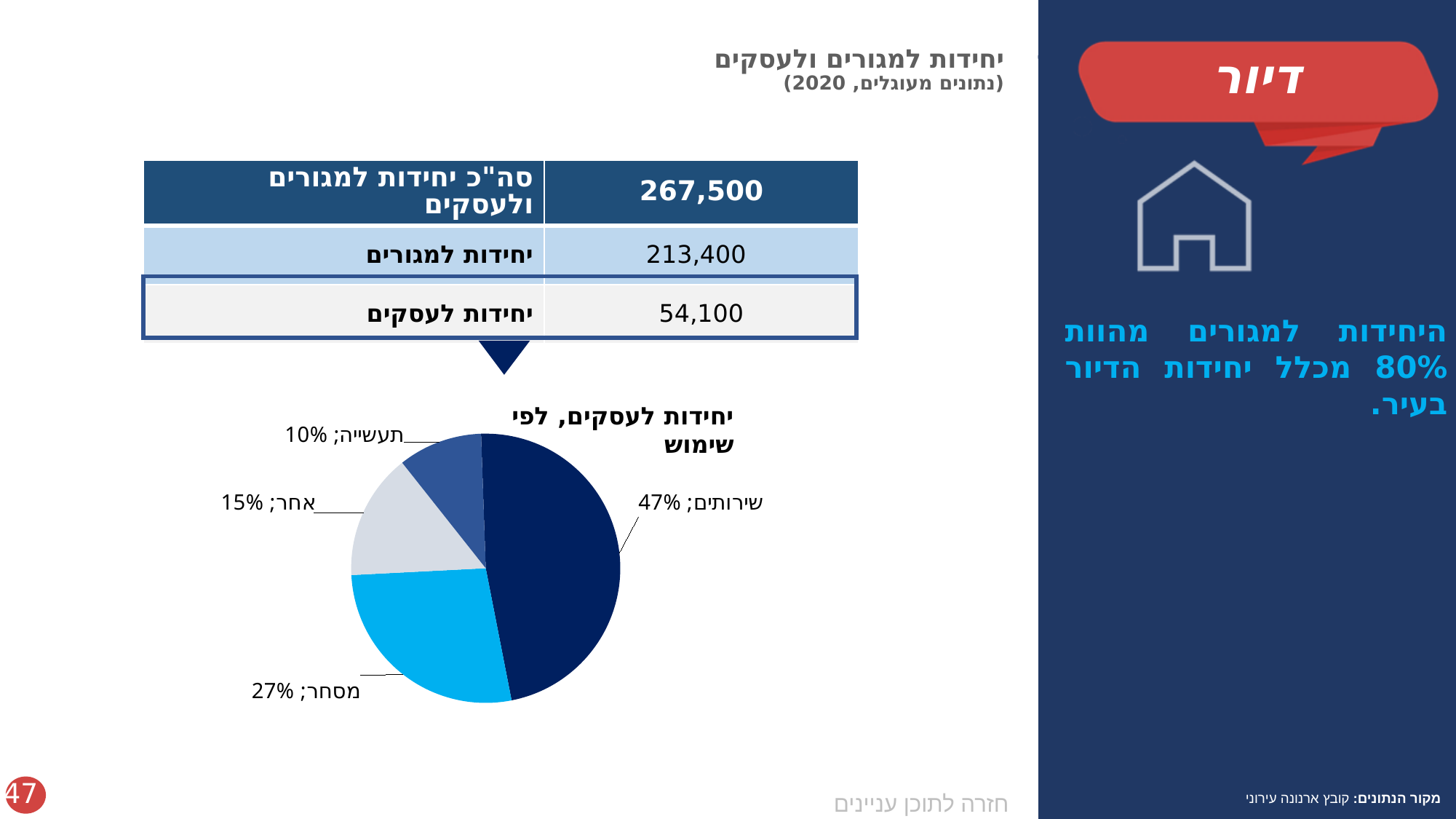
What is the difference in percentage points between מסחר and אחר? 12 Which slice of the pie chart is the smallest? תעשייה What share of the pie does שירותים have? 47% What is the difference in percentage points between שירותים and מסחר? 20 What share of the pie does אחר have? 15% How many slices does the pie chart have? 4 What share of the pie does תעשייה have? 10% What is the title of the pie chart? יחידות לעסקים, לפי שימוש What kind of chart is shown on the slide? pie chart What share of the pie does מסחר have? 27% Which is larger in the pie chart, אחר or תעשייה? אחר Which slice of the pie chart is the largest? שירותים